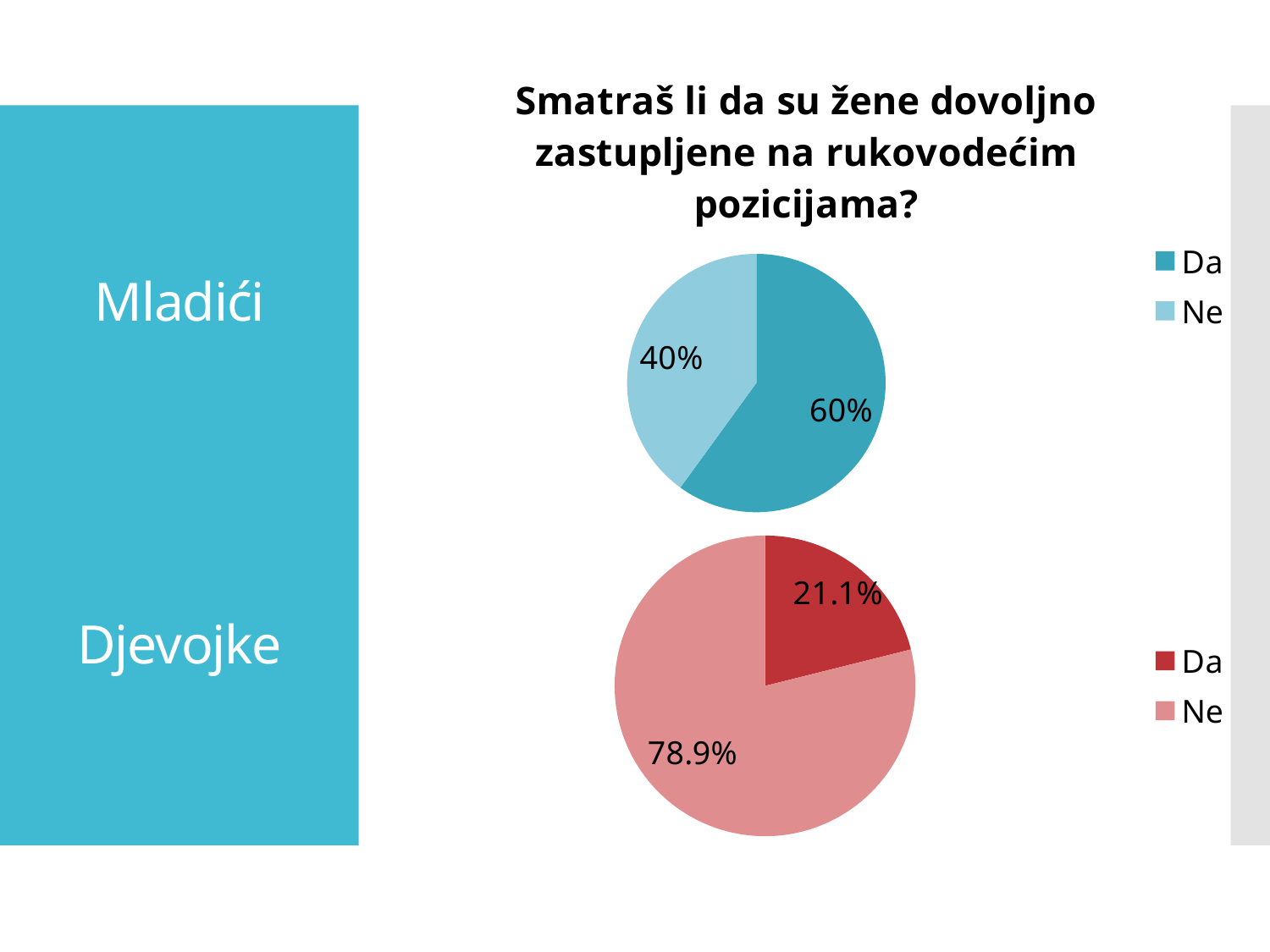
How many slices does the bottom pie chart (Djevojke) have? 2 In the top pie chart (Mladići), what is the difference between the "Da" and "Ne" shares? 20% In the top pie chart (Mladići), what share of responses is "Da"? 60% What type of chart is used on this slide? Pie chart In the top pie chart (Mladići), which response has the larger slice? Da In the bottom pie chart (Djevojke), what share of responses is "Ne"? 78.9% In the top pie chart (Mladići), what share of responses is "Ne"? 40% In the bottom pie chart (Djevojke), what is the difference between the "Ne" and "Da" shares? 57.8% Is the "Da" share larger in the top pie chart (Mladići) or in the bottom pie chart (Djevojke)? Top (Mladići) How many entries does the legend of the top pie chart (Mladići) list? 2 In the bottom pie chart (Djevojke), what share of responses is "Da"? 21.1% In the bottom pie chart (Djevojke), which response has the smaller slice? Da